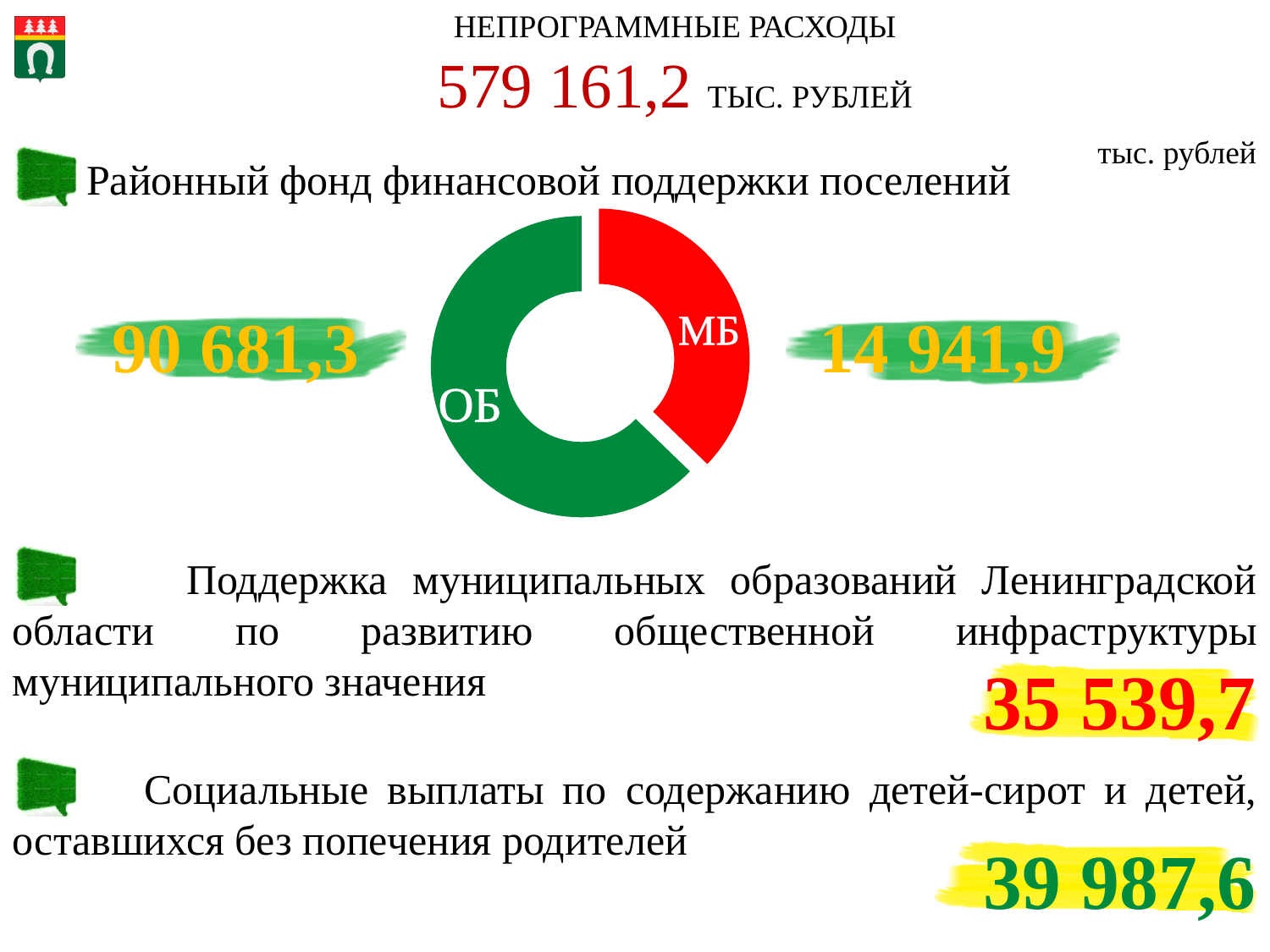
What kind of chart is shown on the slide under the heading "Районный фонд финансовой поддержки поселений"? Doughnut (pie) chart Which segment of the doughnut chart is the smallest? МБ Which segment of the doughnut chart is the largest? ОБ What is the value for ОБ in the doughnut chart? 90 681,3 What is the total of the two segments in the doughnut chart? 105 623,2 What is the value for МБ in the doughnut chart? 14 941,9 Which is larger in the doughnut chart, ОБ or МБ? ОБ How many segments does the doughnut chart have? 2 What colour is the МБ segment of the doughnut chart? Red What is the difference between the ОБ and МБ values in the doughnut chart? 75 739,4 What colour is the ОБ segment of the doughnut chart? Green In what units are the values of the doughnut chart given? тыс. рублей